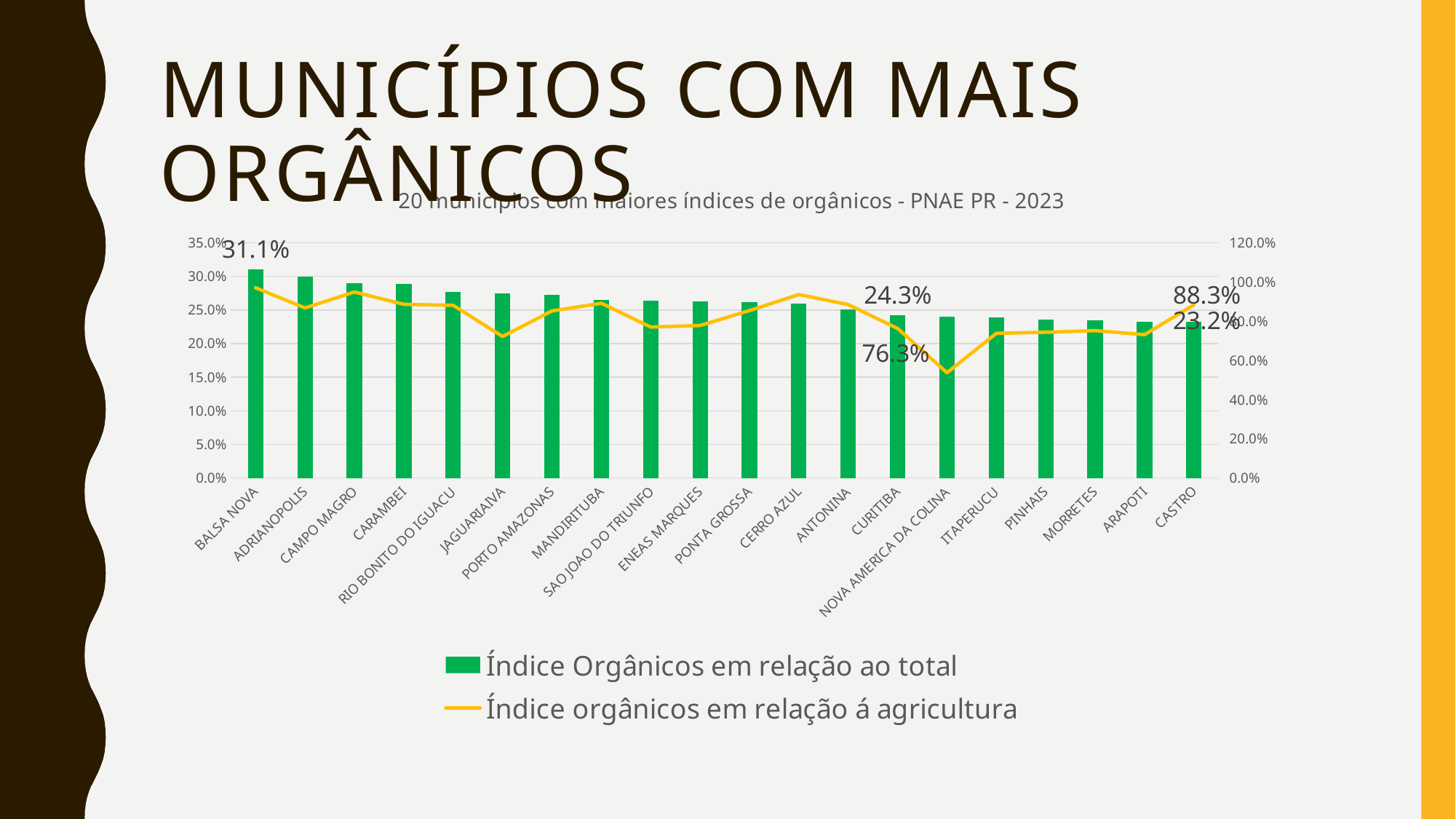
Which municipality has the highest 'Índice Orgânicos em relação ao total'? BALSA NOVA What is the difference between the 'Índice Orgânicos em relação ao total' values for BALSA NOVA and CURITIBA? 6.8 percentage points Is the 'Índice orgânicos em relação á agricultura' value for NOVA AMERICA DA COLINA greater or less than 60%? less What kind of chart is shown on the slide? A bar chart combined with a line What is the value of 'Índice orgânicos em relação á agricultura' for CURITIBA? 76.3% How many series does the legend list? 2 What is the value of 'Índice Orgânicos em relação ao total' for BALSA NOVA? 31.1% What is the value of 'Índice Orgânicos em relação ao total' for CASTRO? 23.2% What is the value of 'Índice orgânicos em relação á agricultura' for CASTRO? 88.3% Do the green bars generally rise or fall from left to right along the x axis? fall How many municipalities are shown on the x axis? 20 What is the value of 'Índice Orgânicos em relação ao total' for CURITIBA? 24.3%